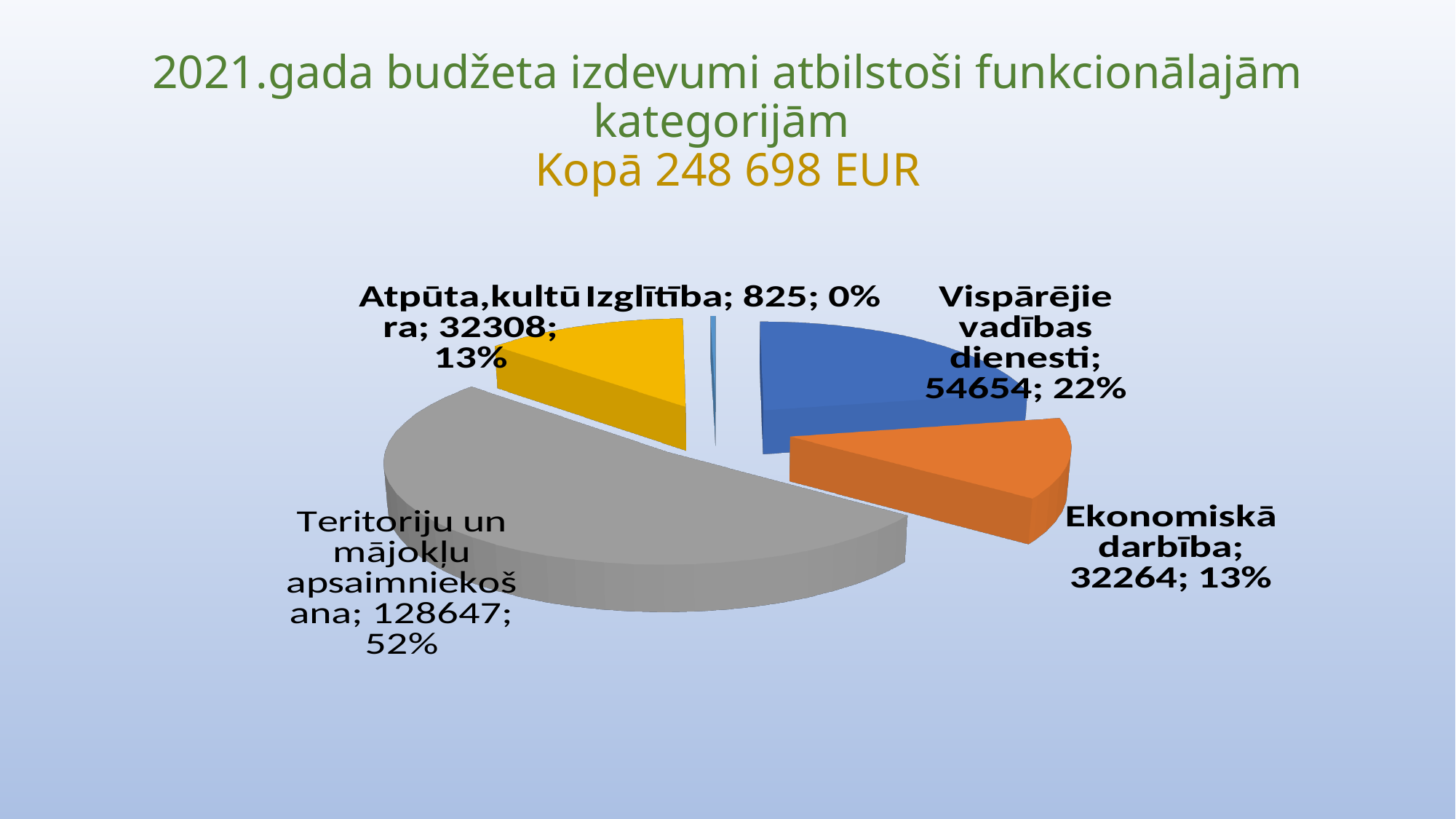
What kind of chart is shown on the slide? pie chart What share of the pie does Teritoriju un mājokļu apsaimniekošana represent? 52% How many slices does the pie chart have? 5 What is the value for Ekonomiskā darbība? 32264 What is the value for Vispārējie vadības dienesti? 54654 What is the difference between the values for Vispārējie vadības dienesti and Ekonomiskā darbība? 22390 What share of the pie does Vispārējie vadības dienesti represent? 22% Which category has the smallest slice? Izglītība Which category has the largest slice? Teritoriju un mājokļu apsaimniekošana What is the value for Izglītība? 825 What total amount in EUR is stated in the chart title? 248 698 EUR What is the value for Teritoriju un mājokļu apsaimniekošana? 128647